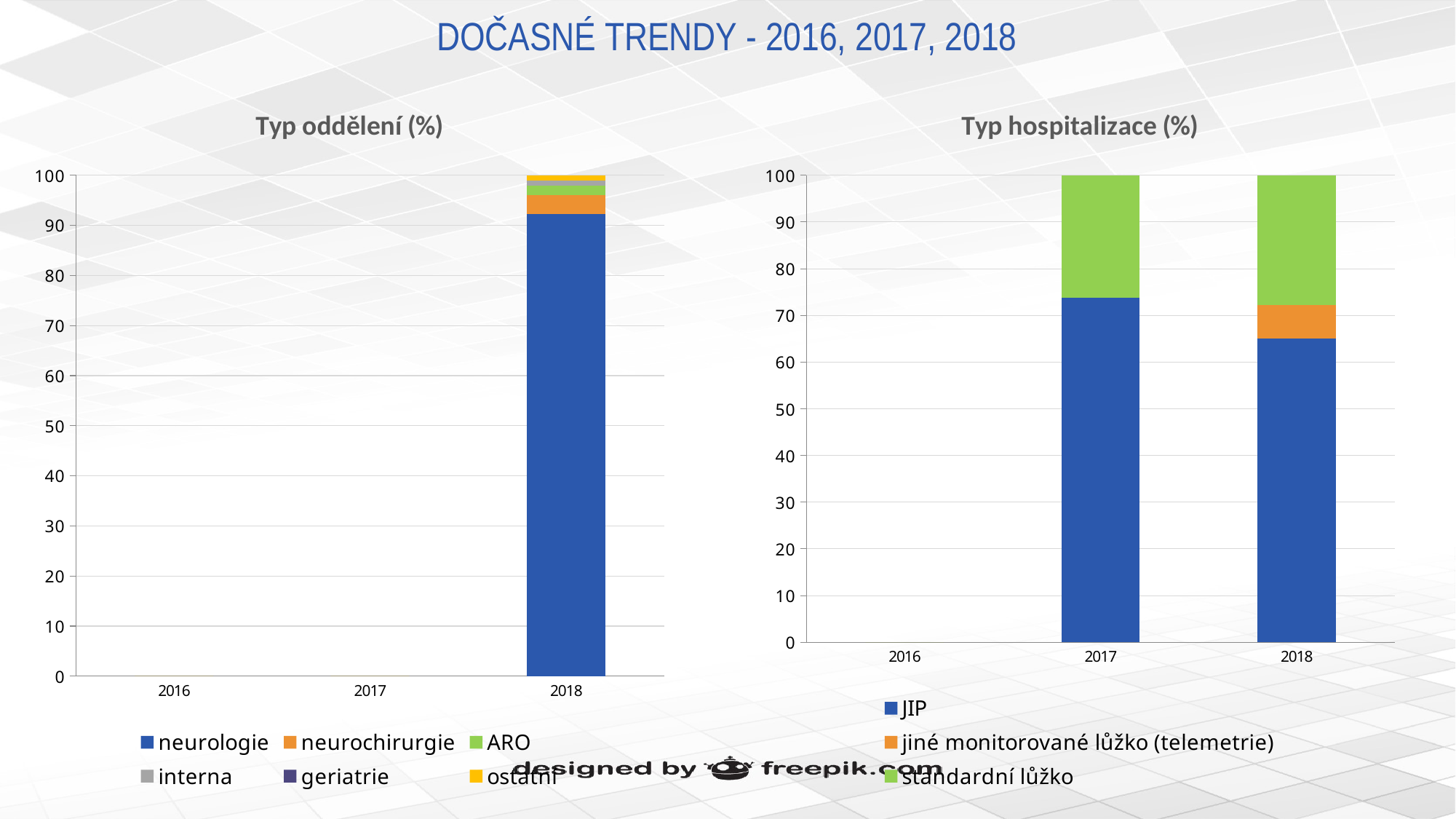
In the "Typ hospitalizace (%)" chart, which year has the larger JIP value, 2017 or 2018? 2017 What kind of chart is the "Typ hospitalizace (%)" chart? stacked bar chart In the "Typ oddělení (%)" chart, is the value for neurologie in 2018 greater or less than 90? greater How many series does the legend of the "Typ oddělení (%)" chart list? 6 How many series does the legend of the "Typ hospitalizace (%)" chart list? 3 How many year categories are shown on the x axis of the "Typ hospitalizace (%)" chart? 3 In the "Typ hospitalizace (%)" chart, is the value for JIP in 2018 greater or less than 70? less In the "Typ oddělení (%)" chart, which year is the only one with a visible bar? 2018 What kind of chart is the "Typ oddělení (%)" chart? stacked bar chart What is the main title of the slide? DOČASNÉ TRENDY - 2016, 2017, 2018 In the "Typ hospitalizace (%)" chart, is the value for JIP in 2017 greater or less than 70? greater In the "Typ hospitalizace (%)" chart, does the JIP share rise or fall from 2017 to 2018? fall